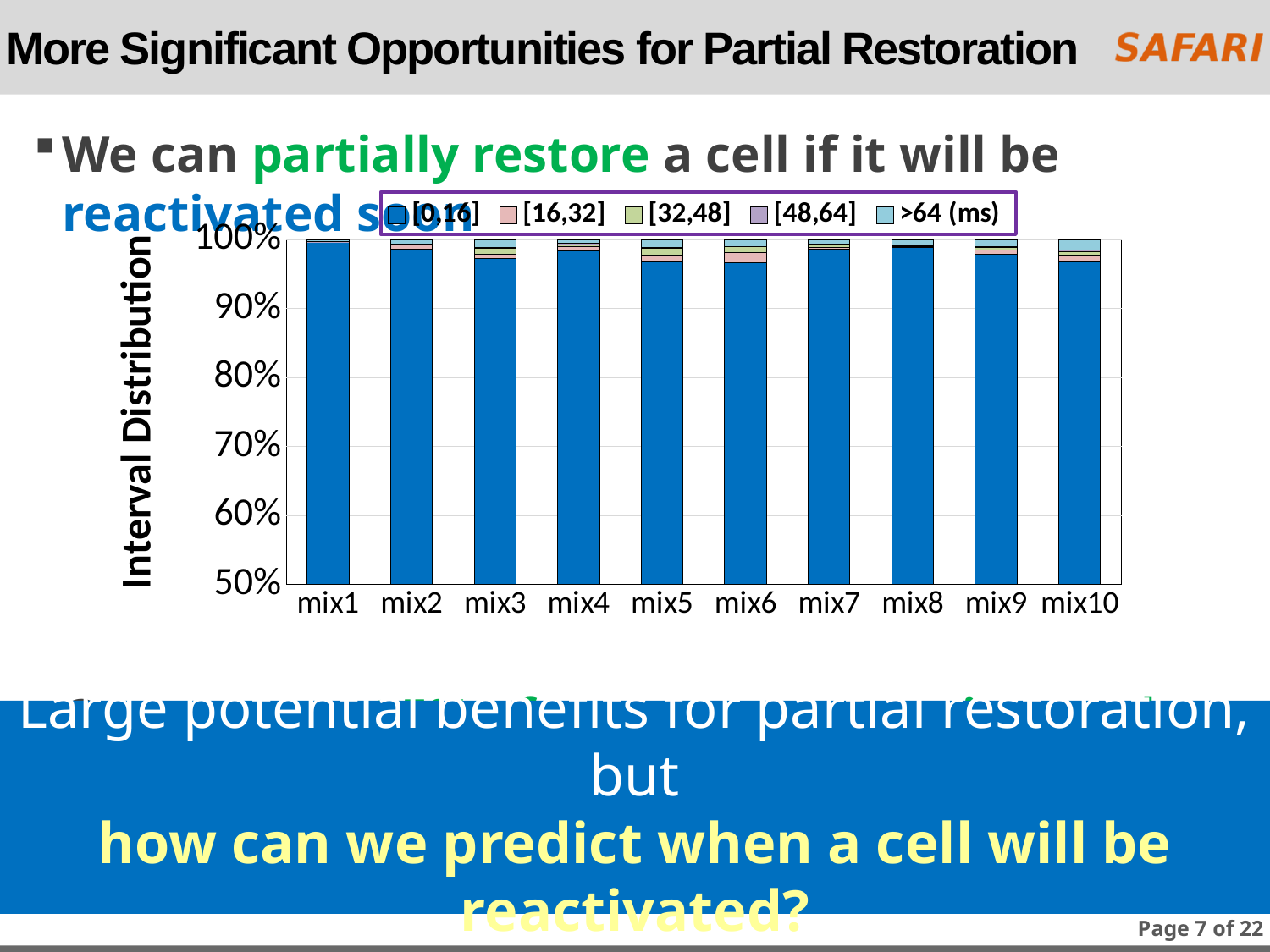
Which mix has the largest [0,16] share in the chart? mix1 Is the [0,16] value for mix10 greater or less than 90%? greater How many categories (mixes) are shown on the x axis of the chart? 10 What kind of chart is shown on the slide? stacked bar chart Which has the larger [0,16] share, mix8 or mix6? mix8 Is the [0,16] value for mix1 greater or less than 90%? greater What is the label of the y axis of the chart? Interval Distribution Which has the larger [0,16] share, mix1 or mix10? mix1 Which legend entry represents intervals longer than 64 ms? >64 (ms) What is the lowest value shown on the y axis of the chart? 50% How many series does the chart's legend list? 5 Is the [0,16] value for mix5 greater or less than 90%? greater